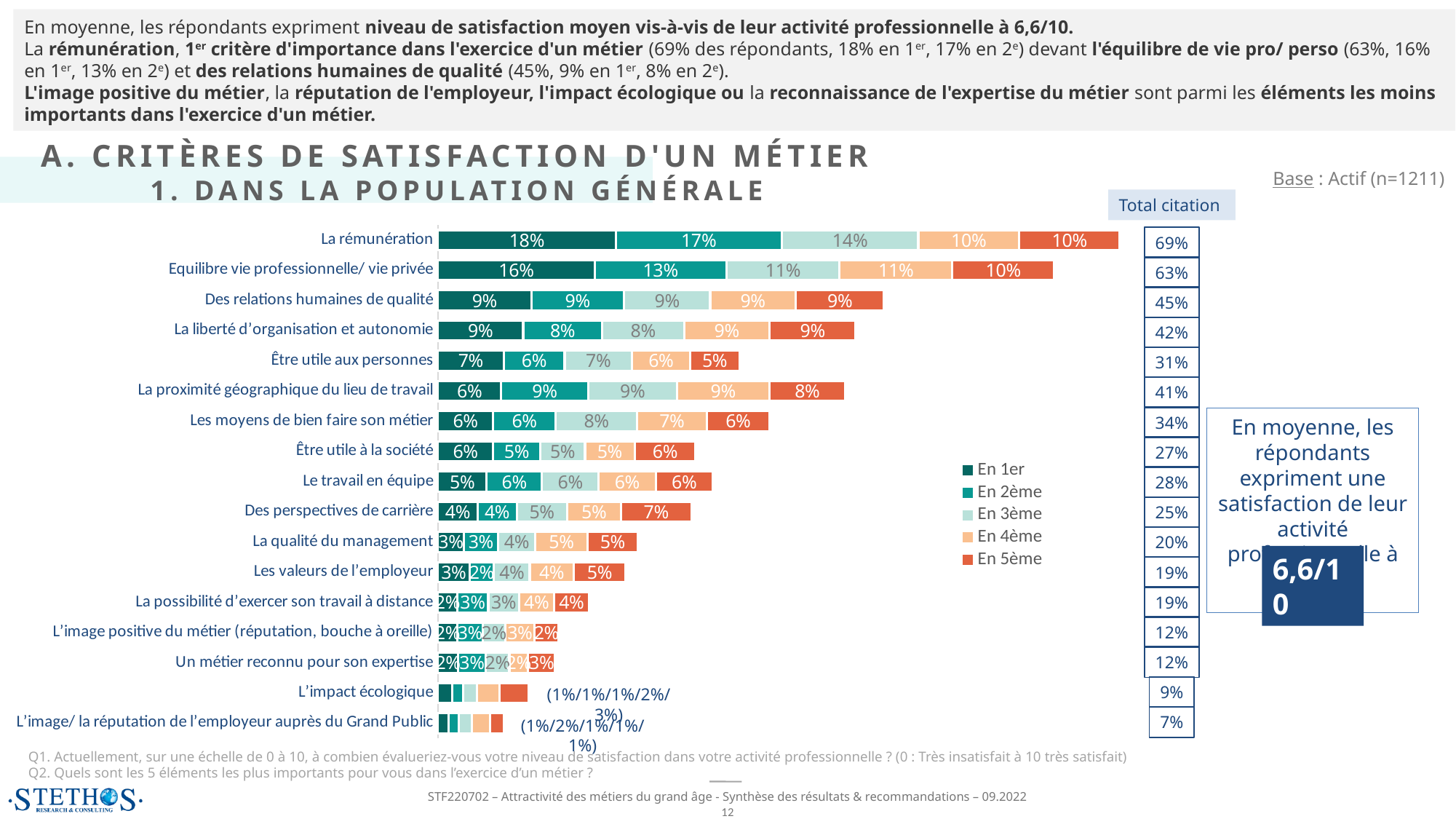
What is the 'En 2ème' value for 'Equilibre vie professionnelle/ vie privée'? 13% Which has the larger 'En 1er' value: 'Être utile aux personnes' or 'La proximité géographique du lieu de travail'? Être utile aux personnes What is the 'En 1er' value for 'La rémunération'? 18% What is the 'En 5ème' value for 'Des perspectives de carrière'? 7% What is the total of the stacked bar for 'Des relations humaines de qualité'? 45% How many series does the legend list? 5 What is the 'Total citation' value for 'Des relations humaines de qualité'? 45% What kind of chart is shown on the slide? Stacked bar chart What is the difference between the 'Total citation' values of 'La rémunération' and 'Equilibre vie professionnelle/ vie privée'? 6 percentage points Which category has the highest 'Total citation' value? La rémunération How many categories are shown in the chart? 17 Which category has the lowest 'Total citation' value? L'image/ la réputation de l'employeur auprès du Grand Public